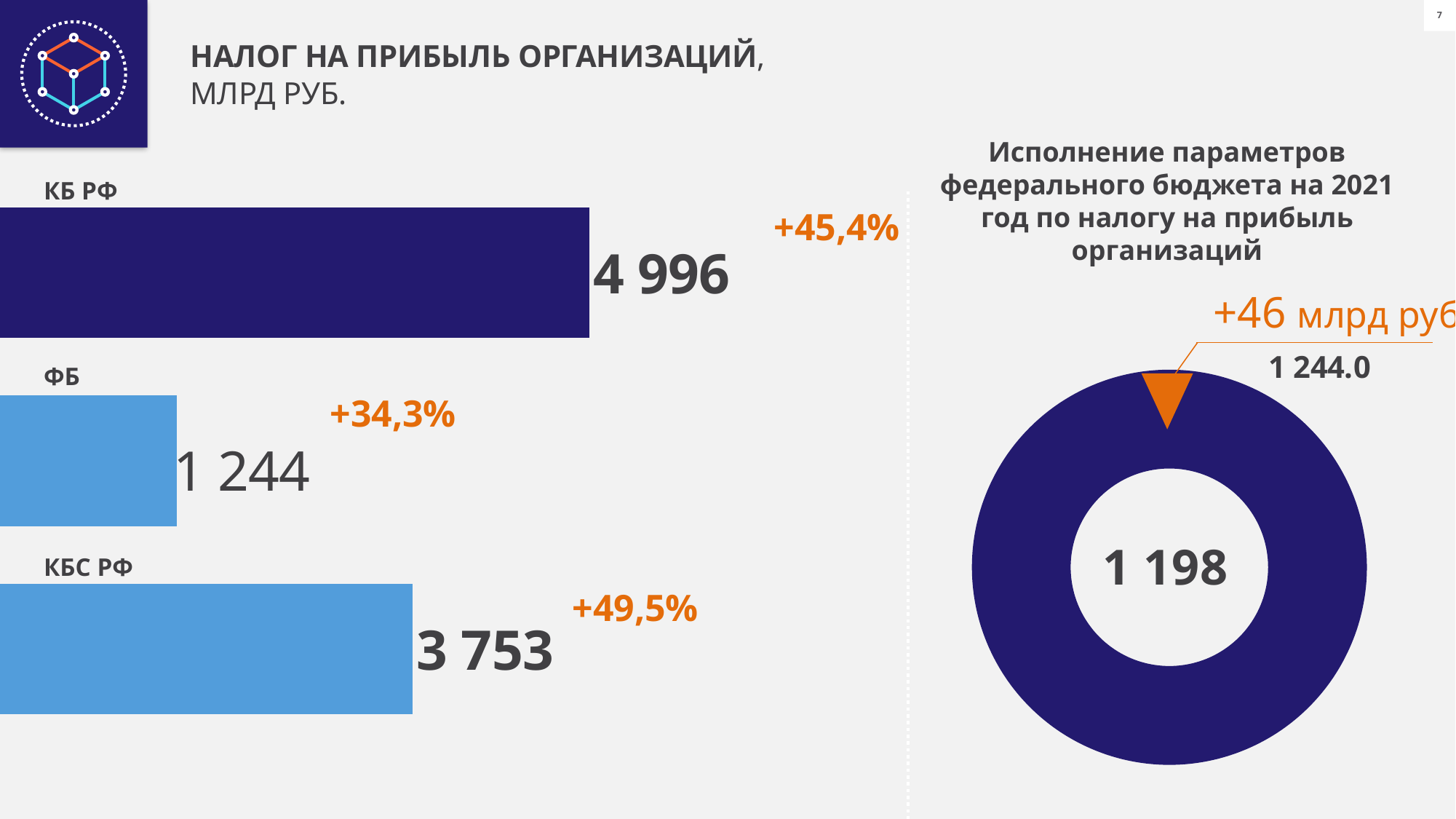
In the bar chart on the left, how many categories are shown? 3 What type of chart is shown on the left side of the slide? bar chart In the bar chart on the left, which category has the highest value? КБ РФ In the bar chart on the left, what percentage change is shown next to the КБС РФ bar? +49,5% In the bar chart on the left, which category has the lowest value? ФБ In the bar chart on the left, what is the value for КБ РФ? 4 996 In the donut chart on the right, what value is printed in the centre? 1 198 In the donut chart on the right, what amount is shown in orange next to the small orange segment? +46 млрд руб In the bar chart on the left, which is larger: the value for КБС РФ or the value for ФБ? КБС РФ In the bar chart on the left, what is the difference between the values for КБ РФ and КБС РФ? 1 243 In the bar chart on the left, what is the value for ФБ? 1 244 In the bar chart on the left, what is the value for КБС РФ? 3 753